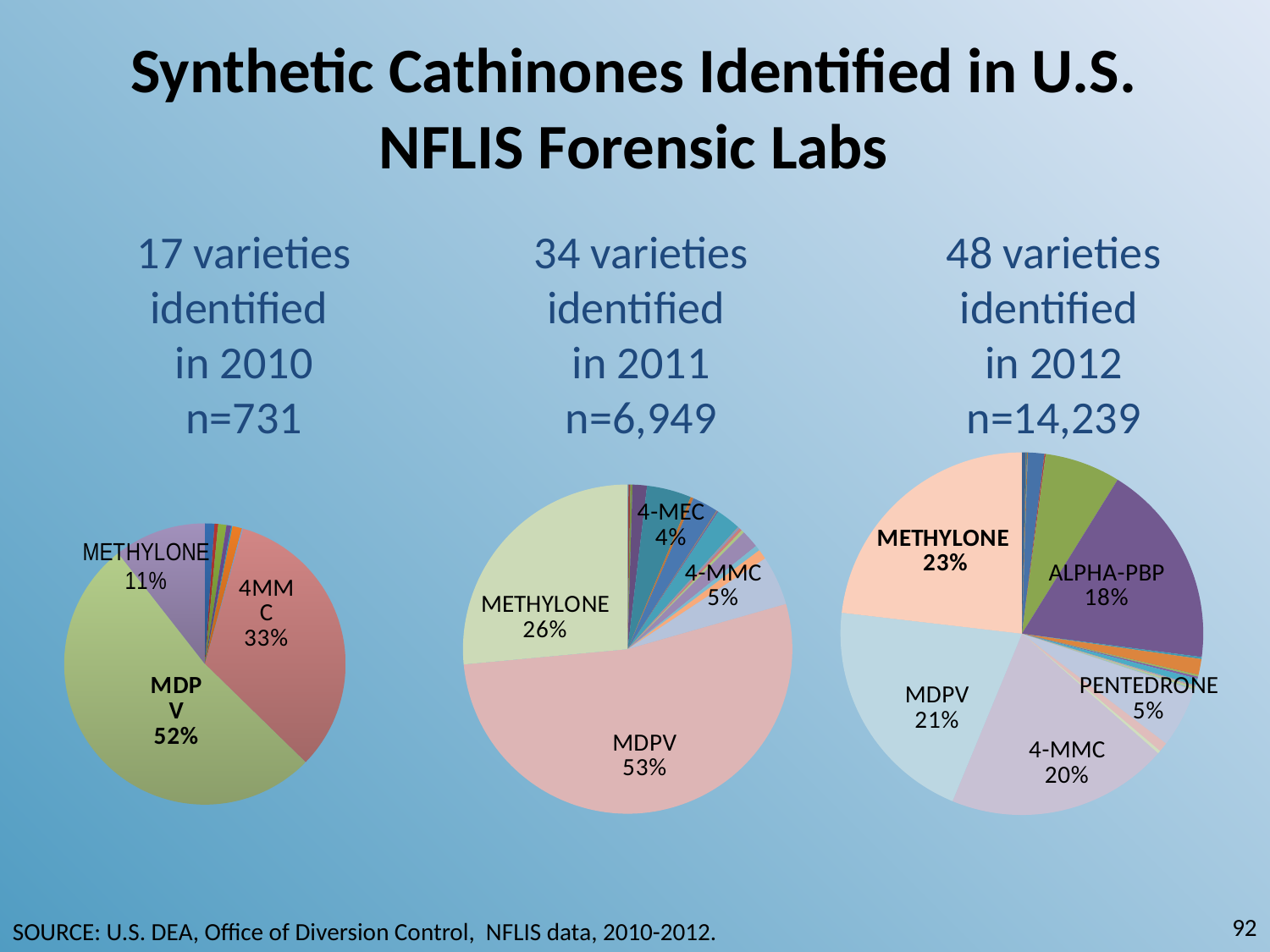
In the 2012 pie chart, which labelled substance has the largest share? METHYLONE In the 2012 pie chart, what is the difference in percentage points between MDPV and 4-MMC? 1 In the 2011 pie chart, what percentage is shown for 4-MEC? 4% In the 2011 pie chart, which is larger, the share for 4-MMC or the share for 4-MEC? 4-MMC In the 2011 pie chart, what share does METHYLONE have? 26% In the 2010 pie chart, what percentage is labelled for 4MMC? 33% In the 2011 pie chart, which labelled substance has the largest share? MDPV What type of chart is used to show the 2012 data? Pie chart In the 2010 pie chart, what is the difference in percentage points between MDPV and METHYLONE? 41 In the 2012 pie chart, what share does ALPHA-PBP have? 18% In the 2012 pie chart, what percentage is labelled for PENTEDRONE? 5% In the 2010 pie chart, what share of the pie does MDPV account for? 52%